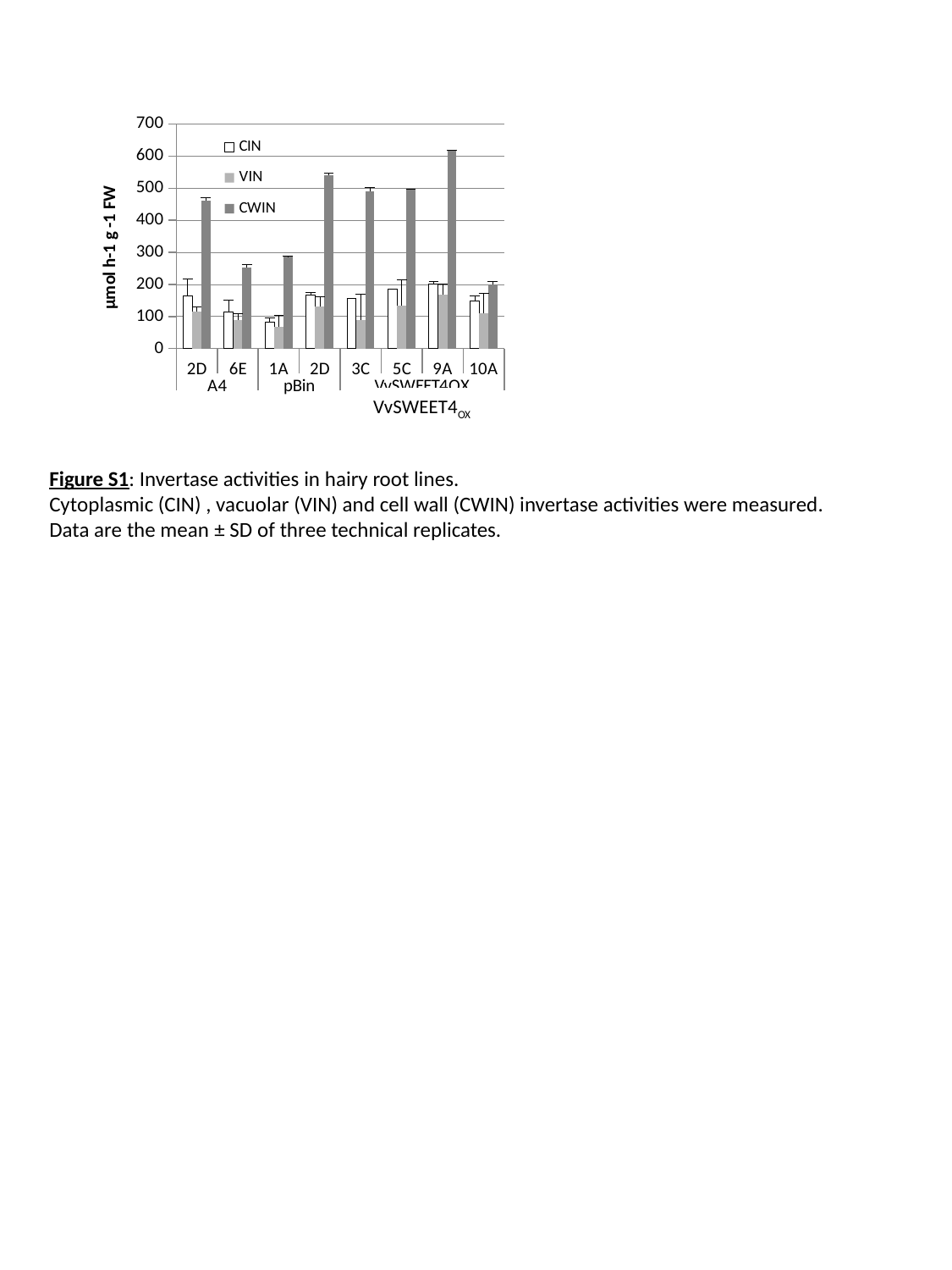
Which series are listed in the legend? CIN, VIN, CWIN Which line has the lowest CWIN value? 10A Is the CWIN value for line 2D in the pBin group greater or less than 500? greater Which is larger for line 3C, the CIN value or the CWIN value? CWIN Is the CWIN value for line 9A greater or less than 600? greater Which line has the highest CWIN value? 9A Is the VIN value for line 1A greater or less than 100? less What is the label of the y axis? µmol h-1 g -1 FW How many series does the legend list? 3 How many hairy root lines (categories) are plotted along the x axis? 8 What kind of chart is shown on the slide? bar chart